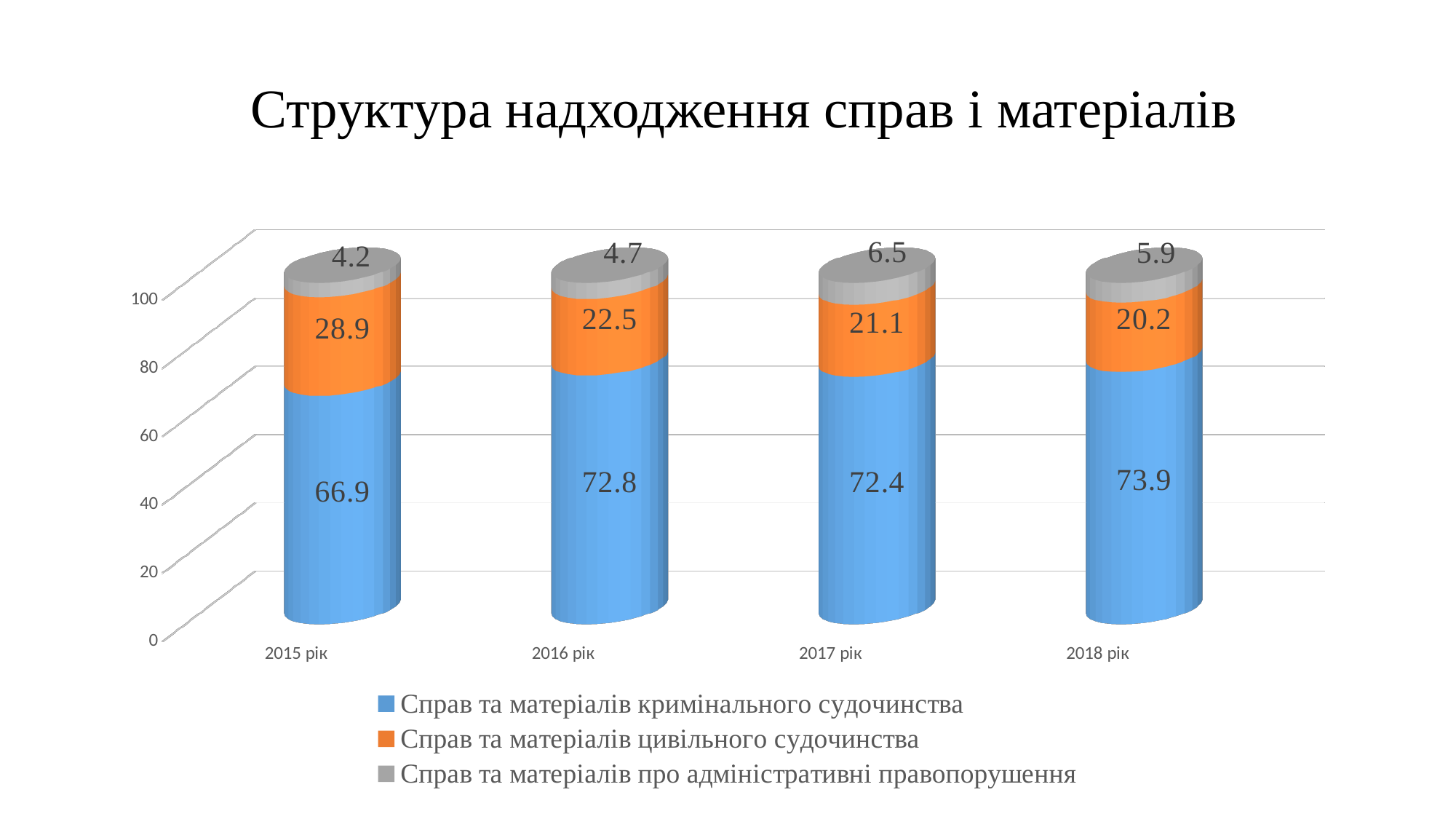
What is the total of the stacked bar for 2016 рік? 100 In which year is the value for 'Справ та матеріалів про адміністративні правопорушення' lowest? 2015 рік What is the title of the chart? Структура надходження справ і матеріалів What kind of chart is shown on the slide? Stacked bar chart What is the value for 'Справ та матеріалів цивільного судочинства' in 2017 рік? 21.1 How many series does the legend list? 3 In which year is the value for 'Справ та матеріалів кримінального судочинства' highest? 2018 рік What is the difference between the 'Справ та матеріалів цивільного судочинства' values for 2015 рік and 2018 рік? 8.7 What is the value for 'Справ та матеріалів кримінального судочинства' in 2015 рік? 66.9 Which is larger: the 'Справ та матеріалів кримінального судочинства' value for 2016 рік or for 2017 рік? 2016 рік How many years (categories) are shown on the x axis? 4 What is the value for 'Справ та матеріалів про адміністративні правопорушення' in 2018 рік? 5.9